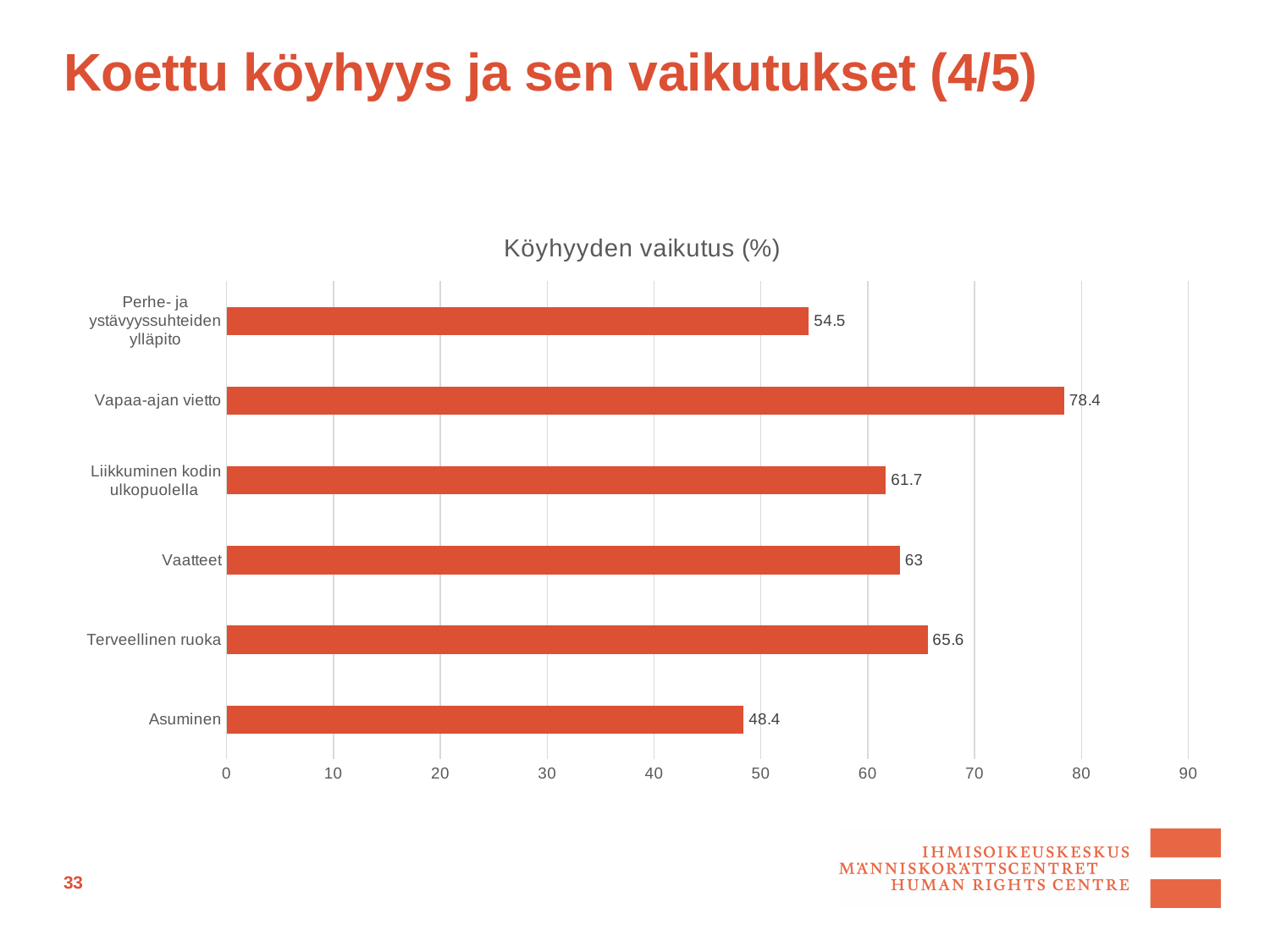
What is the difference between the values for Vapaa-ajan vietto and Asuminen? 30 What is the title of the chart? Köyhyyden vaikutus (%) What is the value for Terveellinen ruoka? 65.6 Which category has the highest value? Vapaa-ajan vietto How many categories are shown in the chart? 6 What kind of chart is shown on the slide? bar chart What is the value for Vapaa-ajan vietto? 78.4 Which is larger, the value for Terveellinen ruoka or the value for Vaatteet? Terveellinen ruoka What is the value for Asuminen? 48.4 Is the value for Perhe- ja ystävyyssuhteiden ylläpito greater or less than 60? less Which category has the lowest value? Asuminen What is the difference between the values for Vaatteet and Liikkuminen kodin ulkopuolella? 1.3